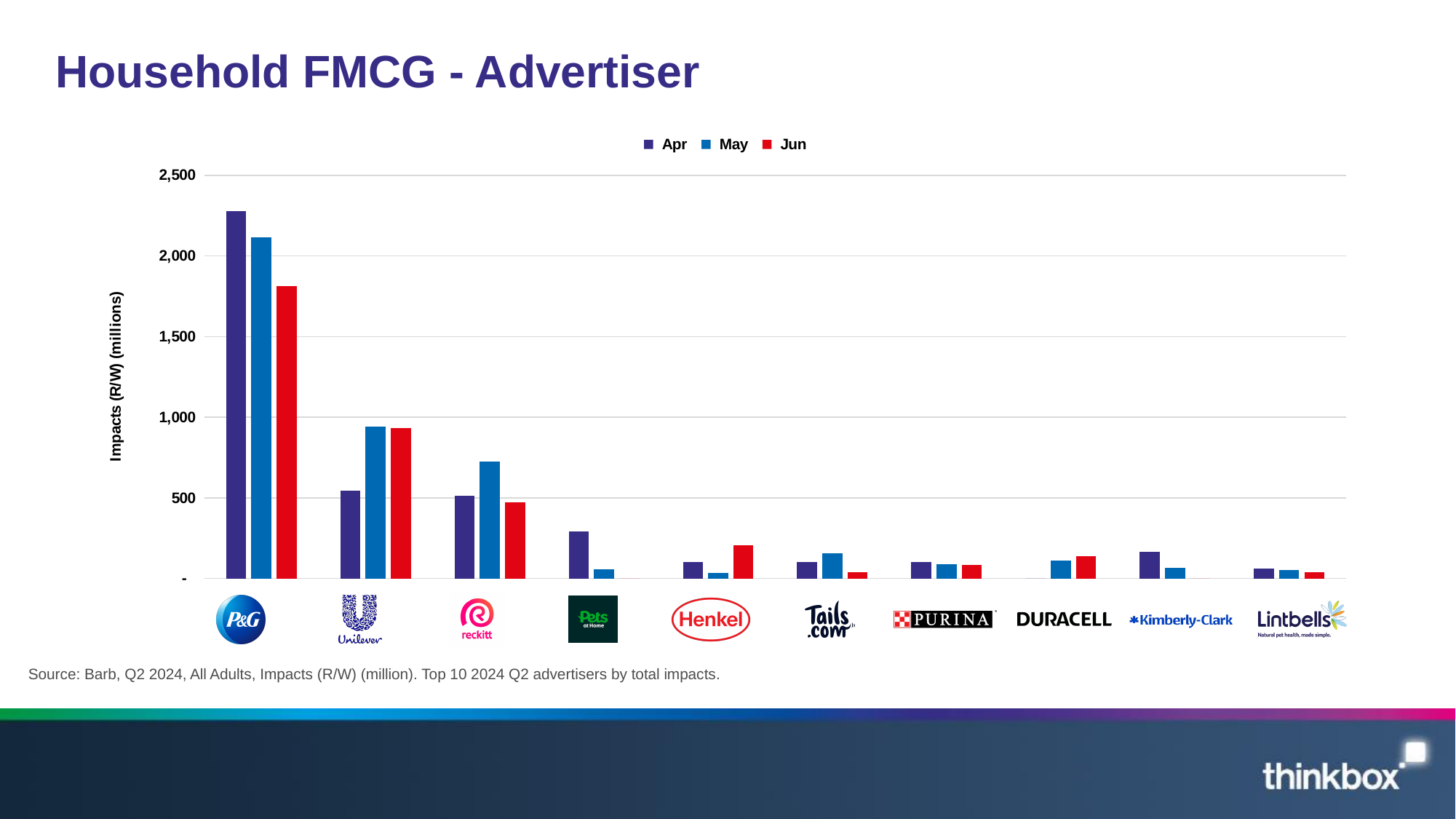
Which is larger, the May value for Unilever or the May value for Reckitt? Unilever What kind of chart is shown on the slide? Bar chart What is the title of the y axis? Impacts (R/W) (millions) Which is larger for Henkel, the Apr value or the Jun value? Jun How many advertisers are shown on the x axis? 10 Which advertiser has the highest Apr value? P&G Do the values for P&G rise or fall from Apr to Jun? fall Is the Apr value for Pets at Home greater or less than 500? less How many series does the legend list? 3 Is the May value for Unilever greater or less than 1,000? less Is the Apr value for P&G greater or less than 2,000? greater